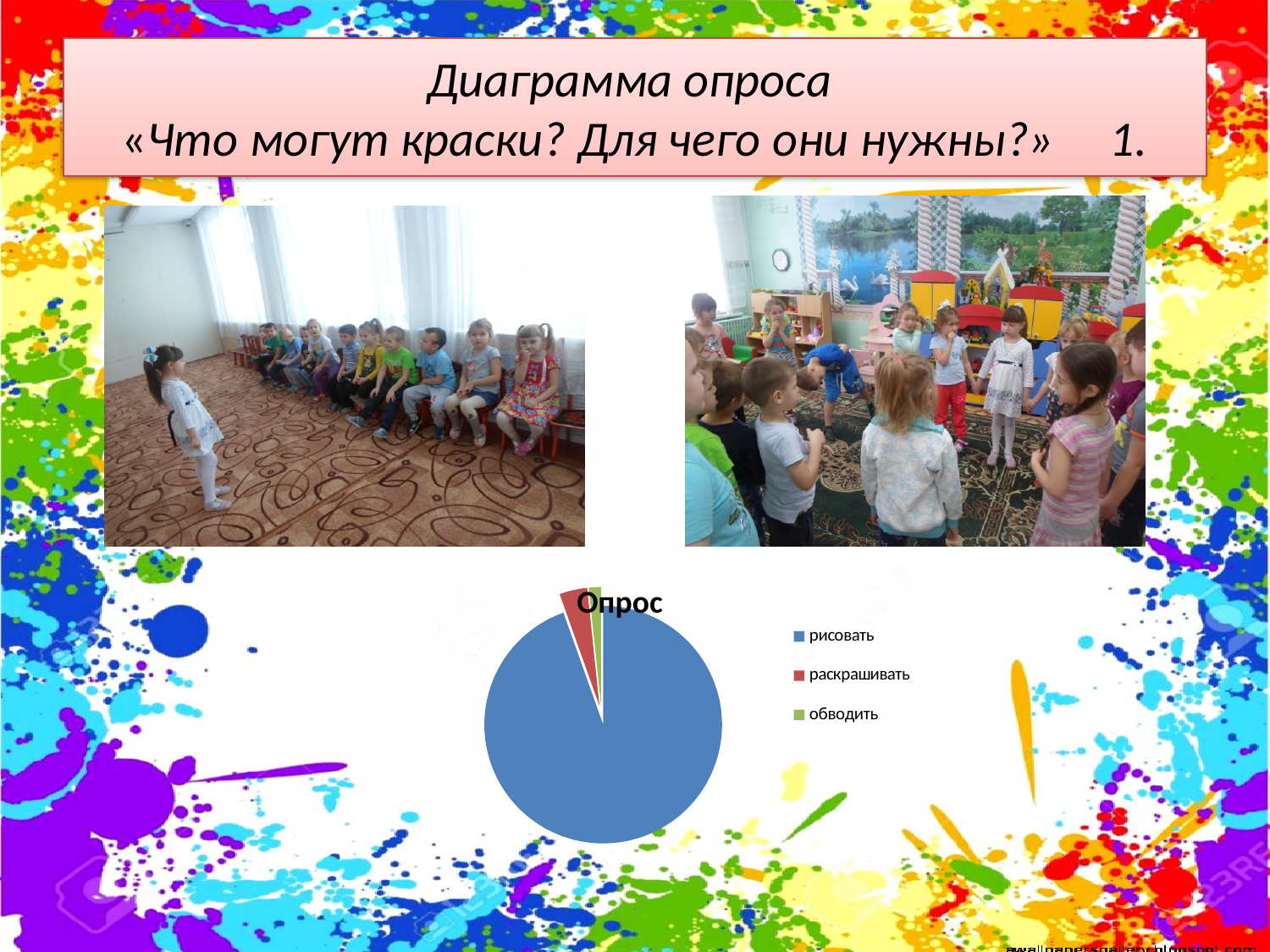
Which category has the largest slice in the pie chart? рисовать How many categories does the legend of the pie chart list? 3 Which category has the smallest slice in the pie chart? обводить What colour is the slice for рисовать in the pie chart? blue Does the slice for рисовать take up more or less than half of the pie? more Which slice is larger in the pie chart, рисовать or раскрашивать? рисовать What kind of chart is shown on the slide? pie chart Which slice is larger in the pie chart, рисовать or обводить? рисовать What is the title of the pie chart? Опрос